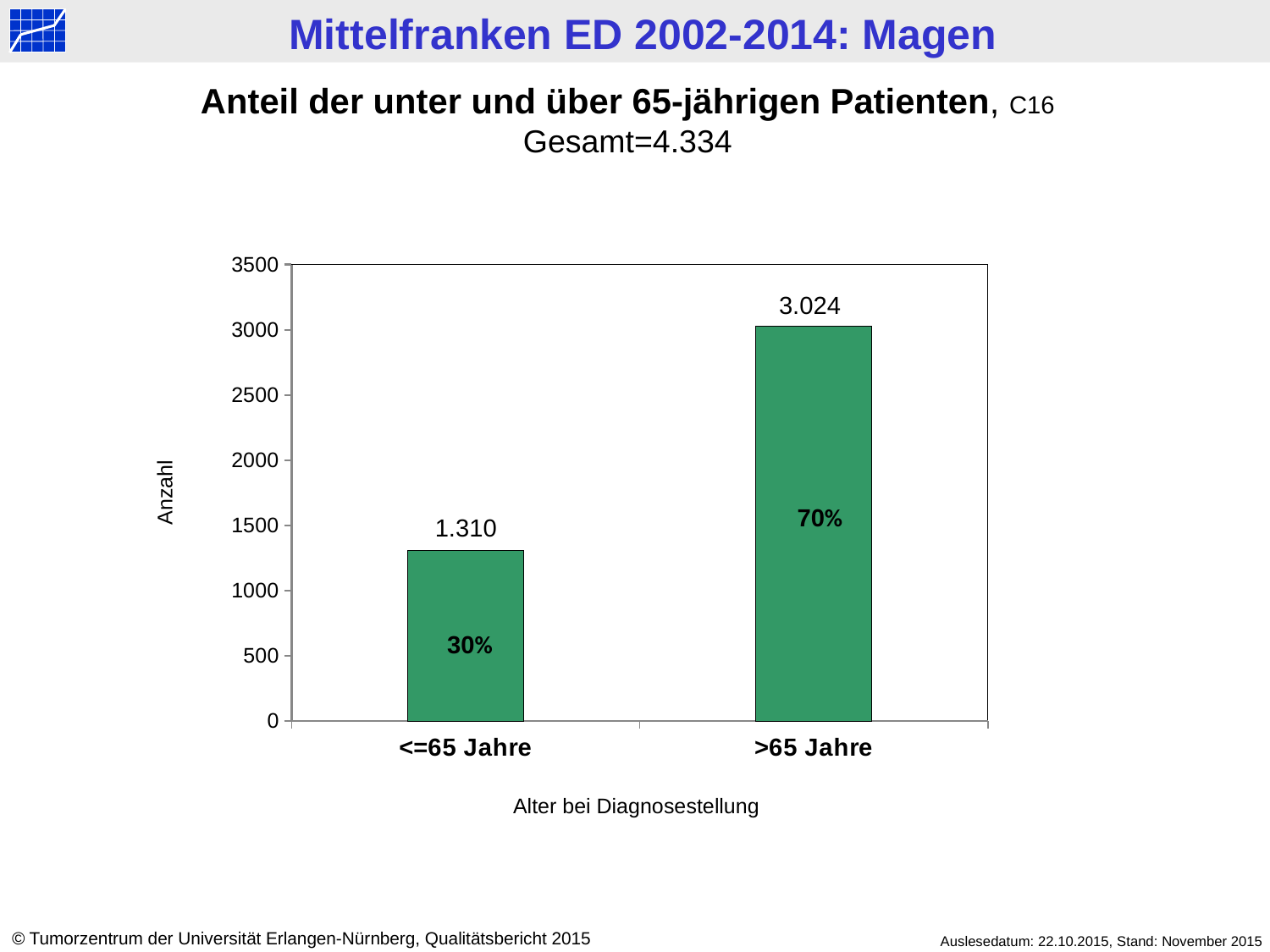
Which is larger, the value for <=65 Jahre or for >65 Jahre? >65 Jahre What kind of chart is shown on the slide? bar chart Which category has the lowest value? <=65 Jahre Which category has the highest value? >65 Jahre Is the value for <=65 Jahre greater or less than 1500? less What is the label of the x axis? Alter bei Diagnosestellung How many categories are shown on the x axis? 2 What percentage is shown on the bar for >65 Jahre? 70% What is the value for the >65 Jahre category? 3.024 What is the difference between the values for >65 Jahre and <=65 Jahre? 1.714 What percentage is shown on the bar for <=65 Jahre? 30% What is the value for the <=65 Jahre category? 1.310